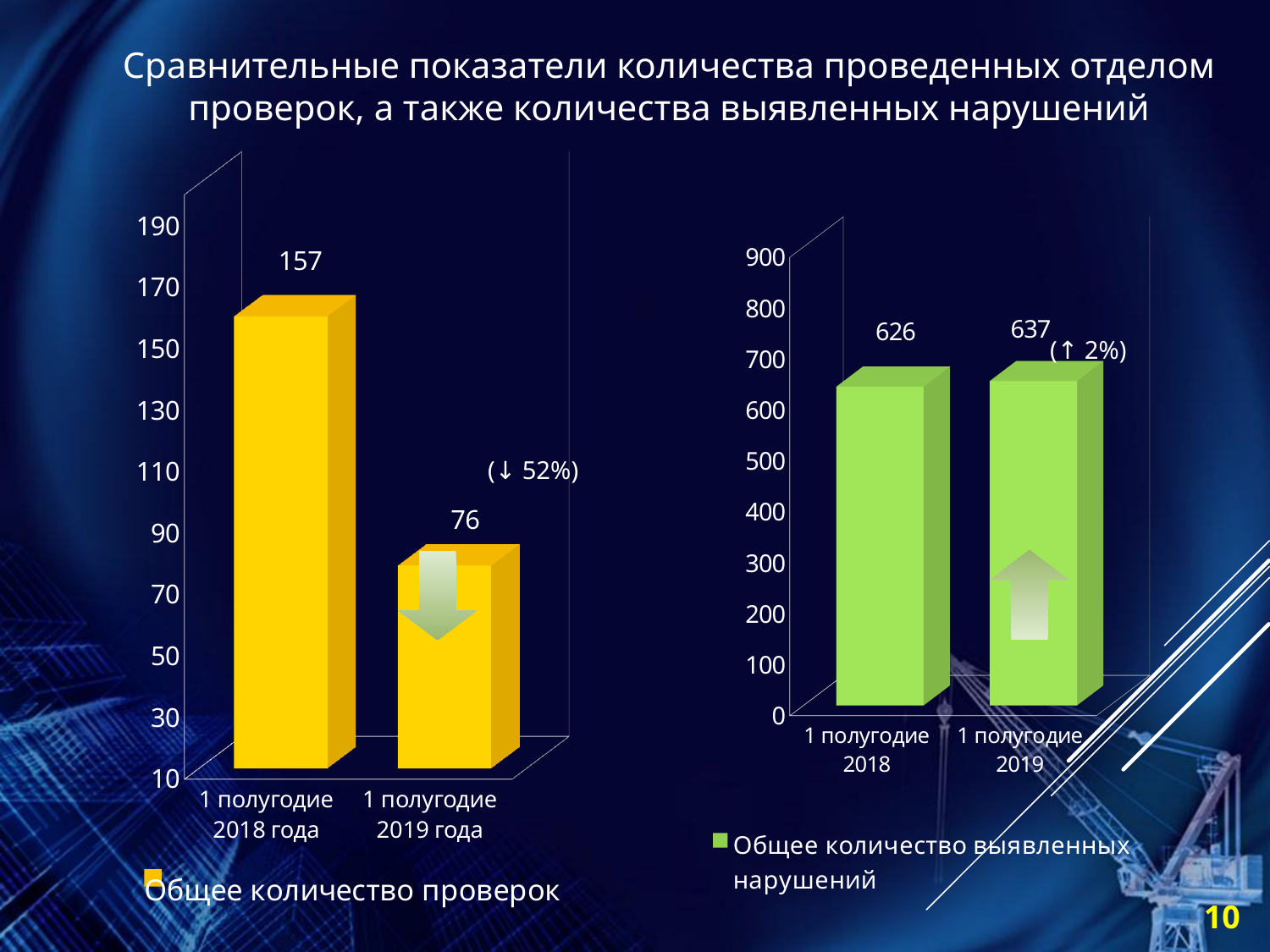
In the left chart (Общее количество проверок), which period has the higher value? 1 полугодие 2018 года In the right chart (Общее количество выявленных нарушений), what is the value for 1 полугодие 2019? 637 In the left chart (Общее количество проверок), do the values rise or fall from 2018 to 2019? fall In the right chart (Общее количество выявленных нарушений), what is the difference between the 2019 and 2018 values? 11 In the left chart (Общее количество проверок), what is the difference between the 2018 and 2019 values? 81 In the right chart (Общее количество выявленных нарушений), do the values rise or fall from 2018 to 2019? rise What percentage change is annotated next to the 2019 bar in the left chart (Общее количество проверок)? ↓ 52% In the right chart (Общее количество выявленных нарушений), what is the value for 1 полугодие 2018? 626 In the left chart (Общее количество проверок), what is the value for 1 полугодие 2018 года? 157 What type of chart is the left chart (Общее количество проверок)? bar chart In the left chart (Общее количество проверок), what is the value for 1 полугодие 2019 года? 76 In the right chart (Общее количество выявленных нарушений), which period has the lower value? 1 полугодие 2018